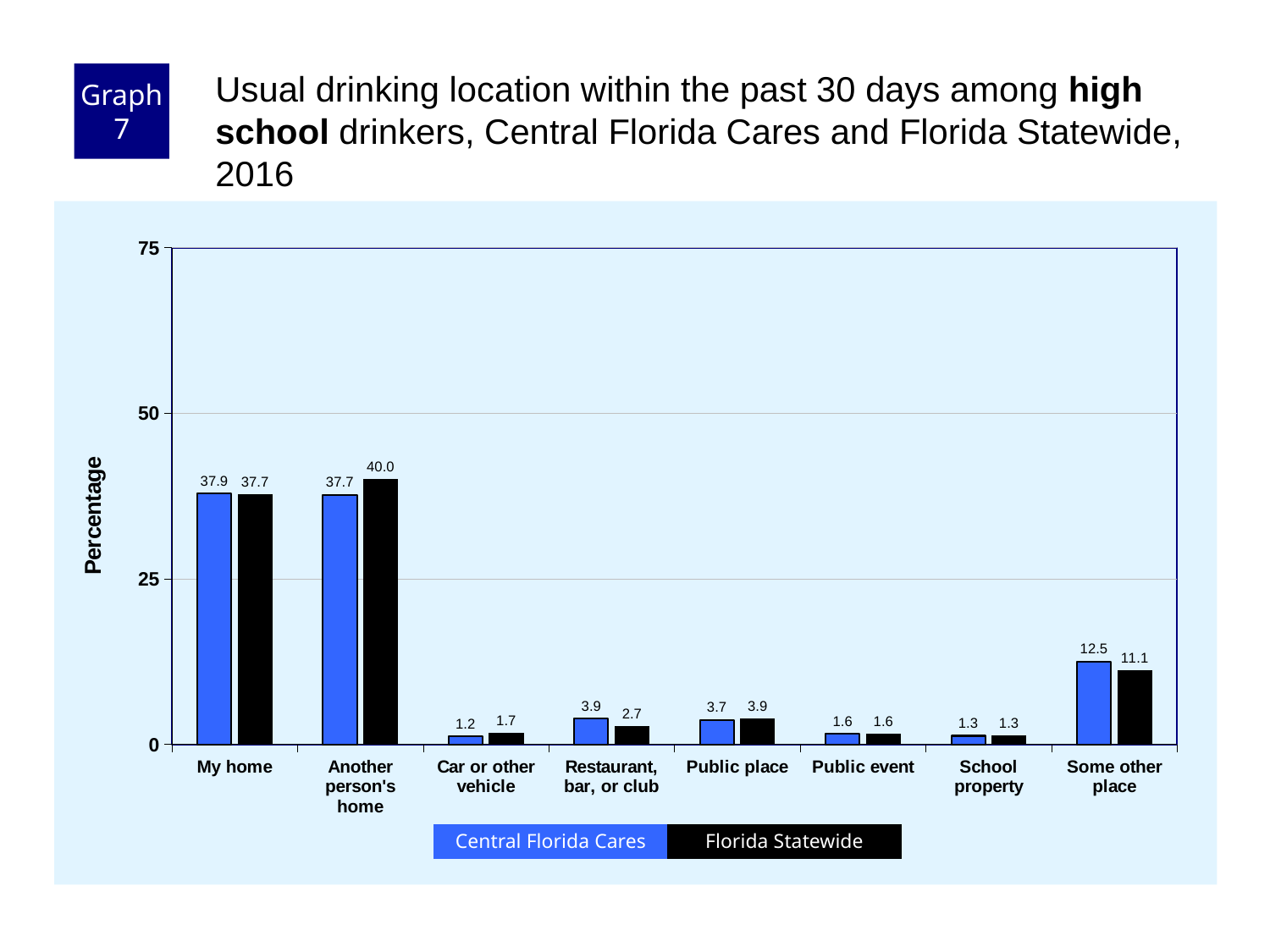
Is the Florida Statewide value for Another person's home greater or less than 50? less What kind of chart is shown on the slide? bar chart What is the Central Florida Cares value for My home? 37.9 How many categories are shown on the x axis? 8 Which category has the highest Florida Statewide value? Another person's home Which category has the lowest Central Florida Cares value? Car or other vehicle How many series does the legend list? 2 What is the Florida Statewide value for Car or other vehicle? 1.7 What is the Florida Statewide value for Another person's home? 40.0 What is the Central Florida Cares value for Some other place? 12.5 Which is larger for Restaurant, bar, or club: Central Florida Cares or Florida Statewide? Central Florida Cares What is the difference between the Central Florida Cares and Florida Statewide values for Some other place? 1.4